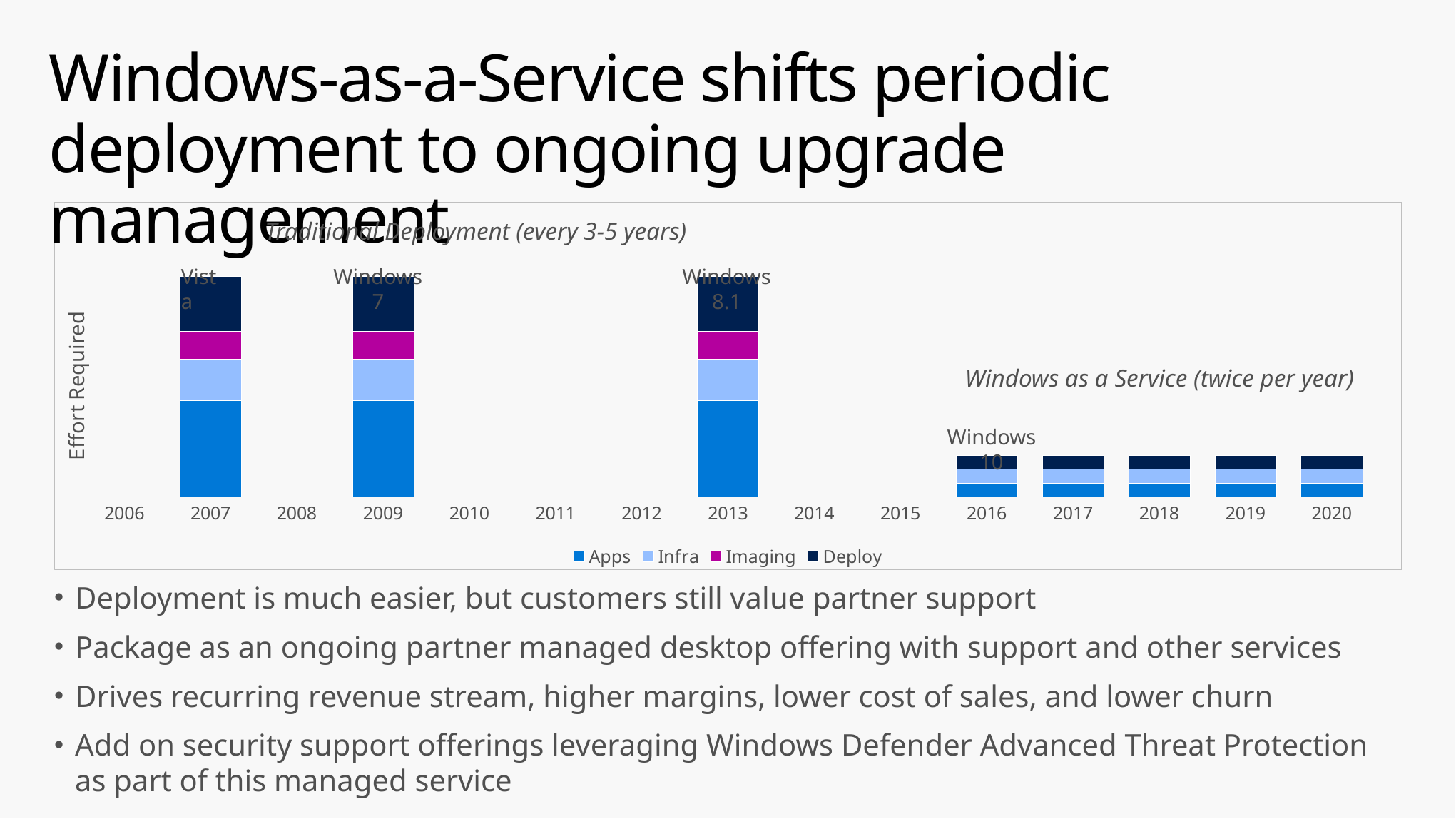
Which series forms the bottom segment of each stacked bar? Apps Which is larger, the Apps segment in 2009 or the Apps segment in 2020? 2009 Which is larger, the total bar for 2013 or the total bar for 2018? 2013 Which series is missing from the bars for 2016 through 2020? Imaging Which is larger, the total bar for 2007 or the total bar for 2016? 2007 What annotation appears above the bars for 2016 to 2020? Windows as a Service (twice per year) Do the bar heights rise or fall moving from 2013 to 2016 along the x axis? Fall How many series does the legend list? 4 What is the label on the vertical axis of the chart? Effort Required What type of chart is shown on the slide? Stacked bar chart How many years are labelled on the x axis of the chart? 15 How many years on the x axis have a bar plotted? 8